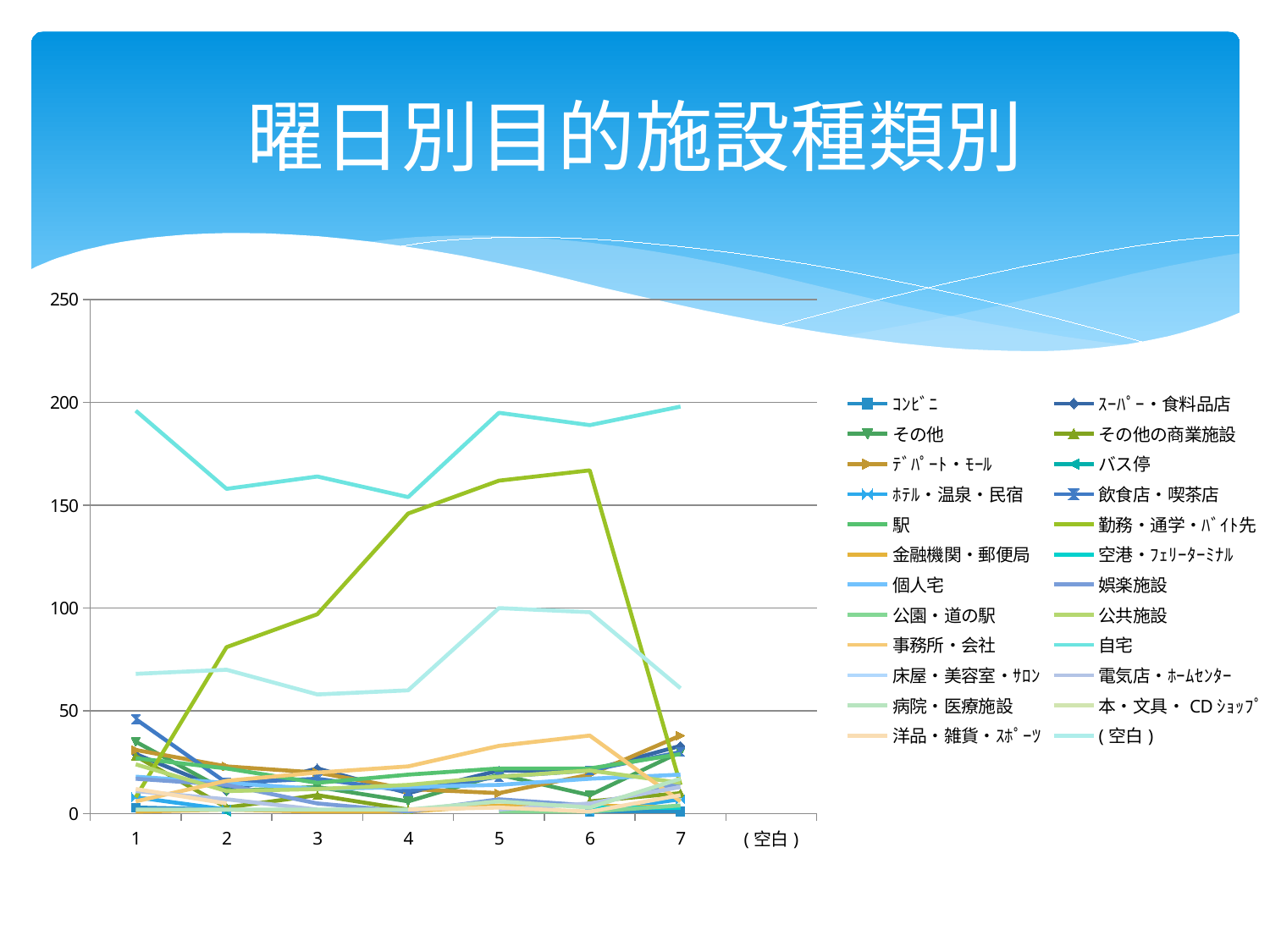
What kind of chart is shown on the slide? line chart Is the value for 勤務・通学・バイト先 at category 1 greater or less than 50? less Is the value for 自宅 at category 4 greater or less than 100? greater Does the 勤務・通学・バイト先 series rise or fall from category 1 to category 6? rise Is the value for 自宅 at category 1 greater or less than 150? greater Which series reaches the highest value on the chart? 自宅 What is the title of the slide's chart? 曜日別目的施設種類別 How many categories are shown along the x axis? 8 How many series does the legend list? 24 At category 6, which is larger: 自宅 or 勤務・通学・バイト先? 自宅